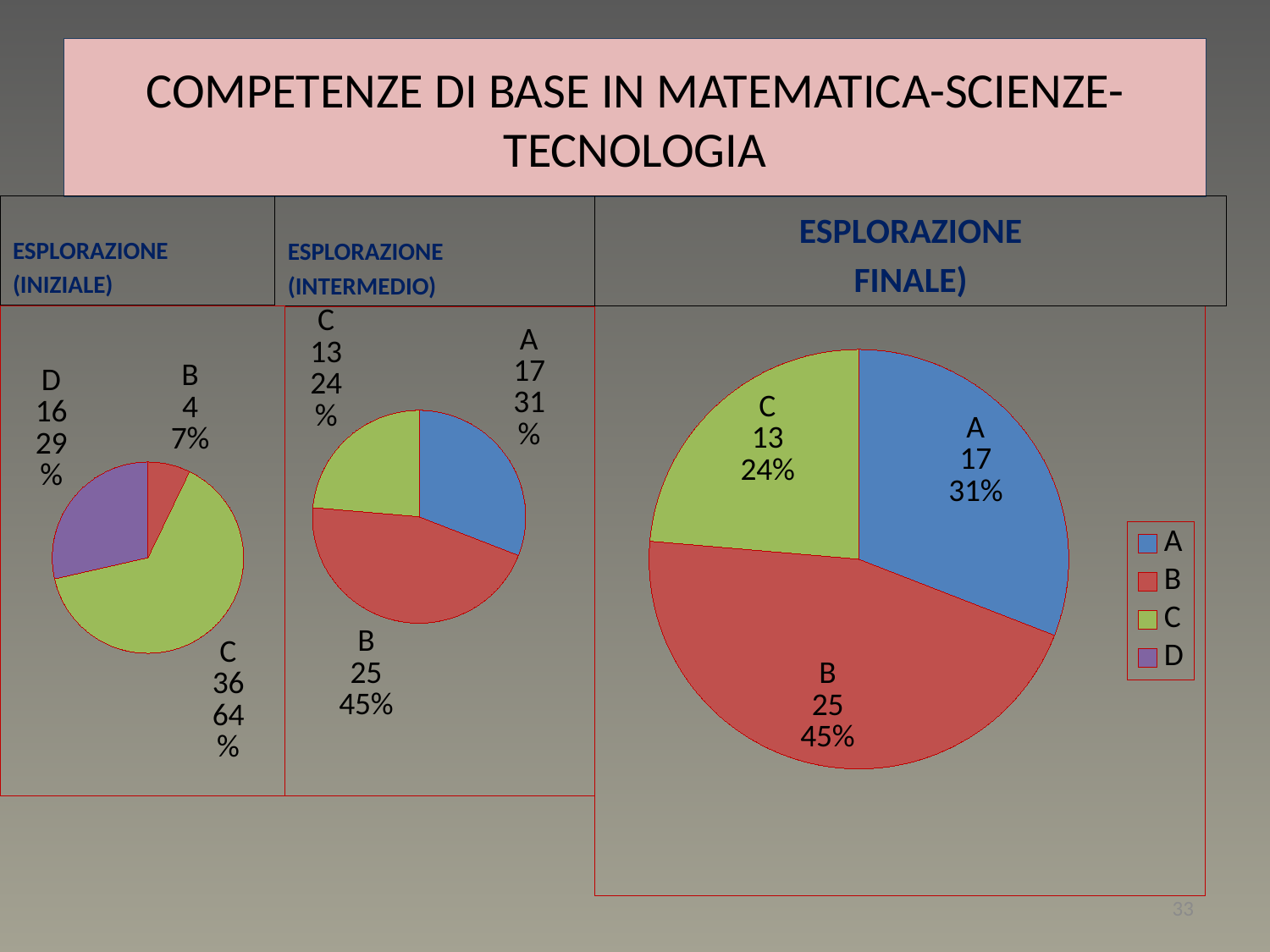
In the ESPLORAZIONE (INIZIALE) chart, what is the value for D? 16 How many entries does the legend of the ESPLORAZIONE FINALE) chart list? 4 In the ESPLORAZIONE (INTERMEDIO) chart, what is the value for A? 17 In the ESPLORAZIONE (INIZIALE) chart, what percentage does slice C represent? 64% In the ESPLORAZIONE FINALE) chart, what percentage does slice B represent? 45% What type of chart is the ESPLORAZIONE FINALE) chart? Pie chart In the ESPLORAZIONE (INTERMEDIO) chart, what is the difference between the values for B and C? 12 In the ESPLORAZIONE (INIZIALE) chart, how many slices does the pie have? 3 In the ESPLORAZIONE (INTERMEDIO) chart, which category has the largest slice? B In the ESPLORAZIONE FINALE) chart, what is the value for C? 13 In the ESPLORAZIONE FINALE) chart, which is larger, the value for A or the value for C? A In the ESPLORAZIONE (INIZIALE) chart, which category has the smallest slice? B